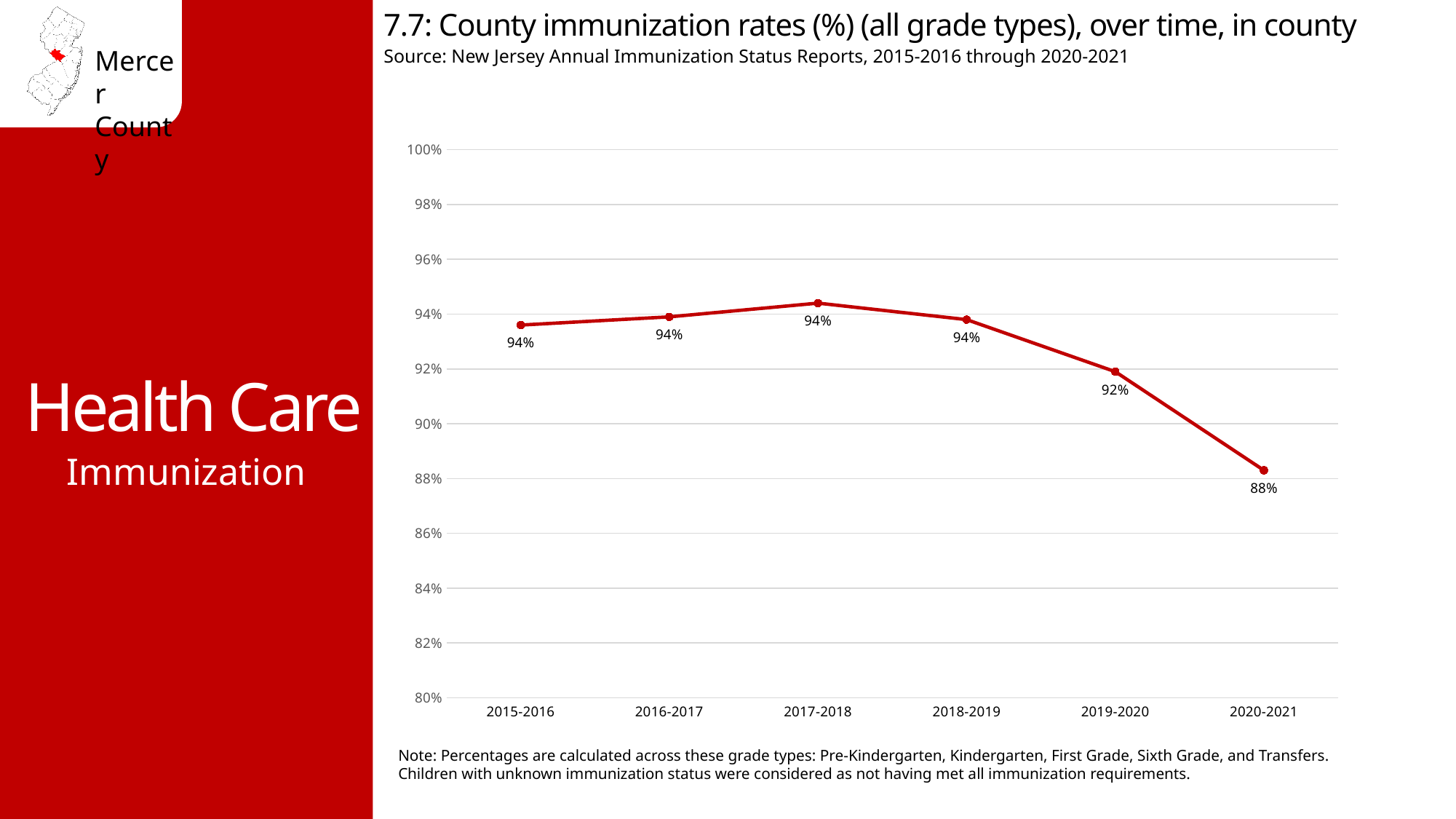
What is the county immunization rate for 2015-2016? 94% Does the immunization rate rise or fall from 2018-2019 to 2020-2021? falls Is the immunization rate for 2019-2020 greater or less than 90%? greater Which is larger, the immunization rate for 2018-2019 or for 2020-2021? 2018-2019 Is the immunization rate for 2020-2021 greater or less than 90%? less What is the difference in immunization rate between 2018-2019 and 2020-2021? 6 percentage points Which school year has the lowest immunization rate? 2020-2021 How many school years are plotted on the chart? 6 What is the difference in immunization rate between 2019-2020 and 2020-2021? 4 percentage points What type of chart is shown on the slide? Line chart What is the county immunization rate for 2019-2020? 92% What is the county immunization rate for 2020-2021? 88%